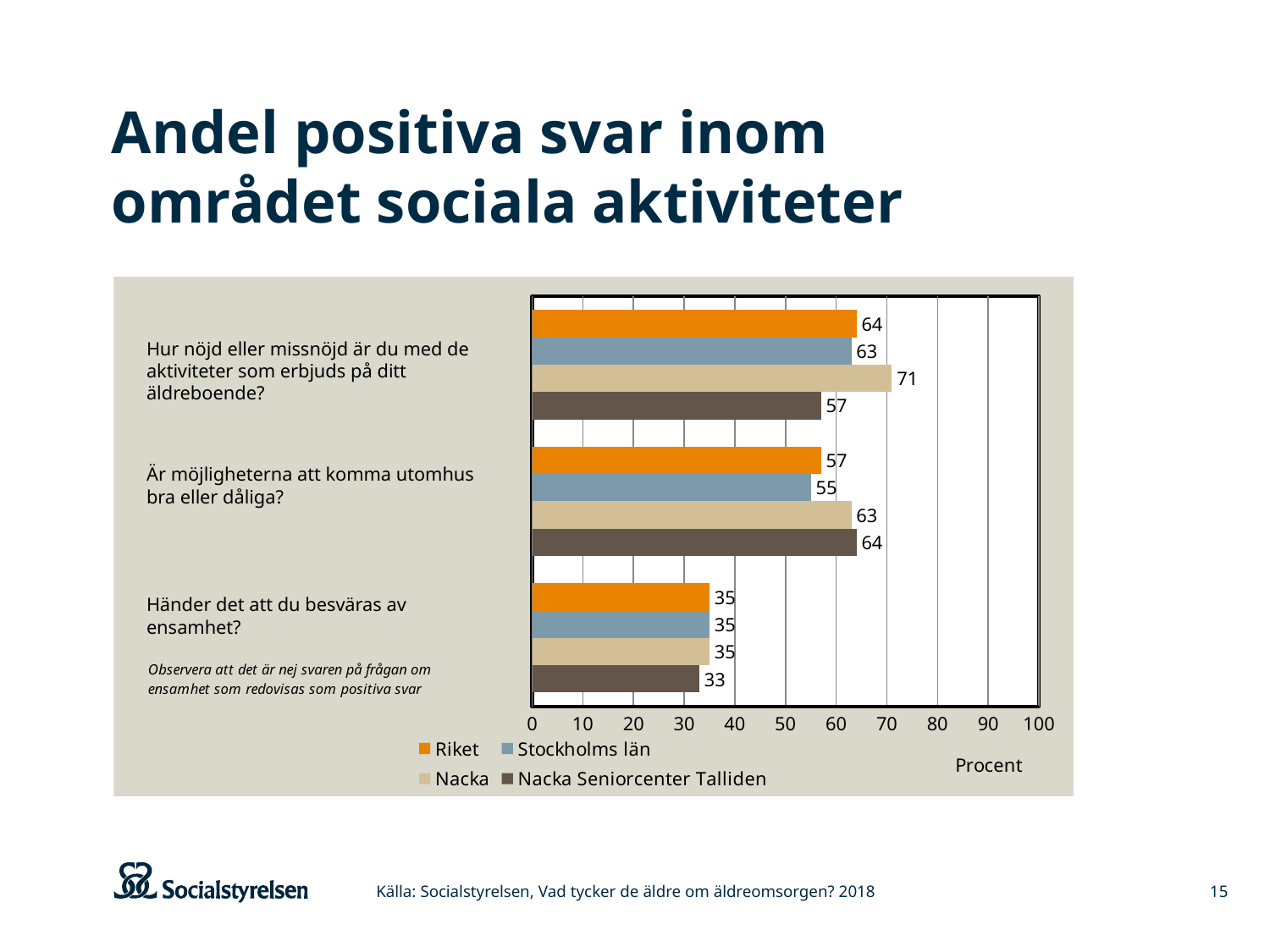
On the question "Är möjligheterna att komma utomhus bra eller dåliga?", which is larger: the value for Riket or the value for Nacka? Nacka What is the label of the horizontal axis? Procent What is the difference between the Nacka value and the Nacka Seniorcenter Talliden value on the question "Hur nöjd eller missnöjd är du med de aktiviteter som erbjuds på ditt äldreboende?"? 14 What is the value for Nacka Seniorcenter Talliden on the question "Är möjligheterna att komma utomhus bra eller dåliga?"? 64 How many questions (categories) are shown on the chart? 3 What kind of chart is shown on the slide? Bar chart How many series does the legend list? 4 What is the value for Stockholms län on the question "Är möjligheterna att komma utomhus bra eller dåliga?"? 55 Which series has the highest value on the question "Hur nöjd eller missnöjd är du med de aktiviteter som erbjuds på ditt äldreboende?"? Nacka What is the value for Nacka on the question "Hur nöjd eller missnöjd är du med de aktiviteter som erbjuds på ditt äldreboende?"? 71 Which series has the lowest value on the question "Händer det att du besväras av ensamhet?"? Nacka Seniorcenter Talliden What is the value for Riket on the question "Händer det att du besväras av ensamhet?"? 35